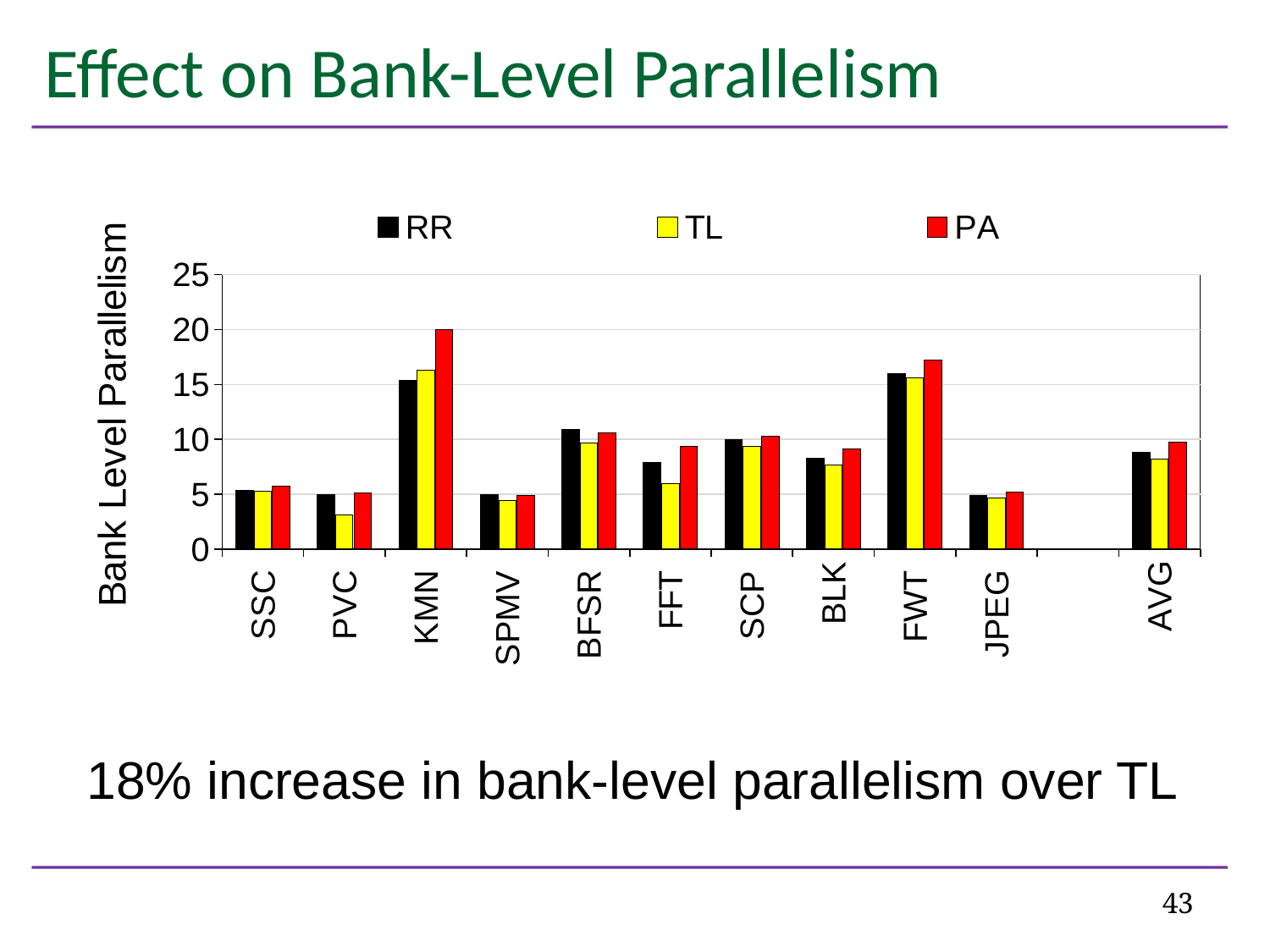
Is the TL value for FFT greater or less than 10? less Which is larger, the PA value for KMN or the PA value for FWT? KMN What is the label of the y axis? Bank Level Parallelism What kind of chart is shown on the slide? bar chart Is the PA value for KMN greater or less than 15? greater How many series does the legend list? 3 Is the TL value for PVC greater or less than 5? less For FFT, which is larger, the RR value or the TL value? RR Which category has the lowest TL value? PVC How many categories are shown along the x axis? 11 Which category has the highest PA value? KMN